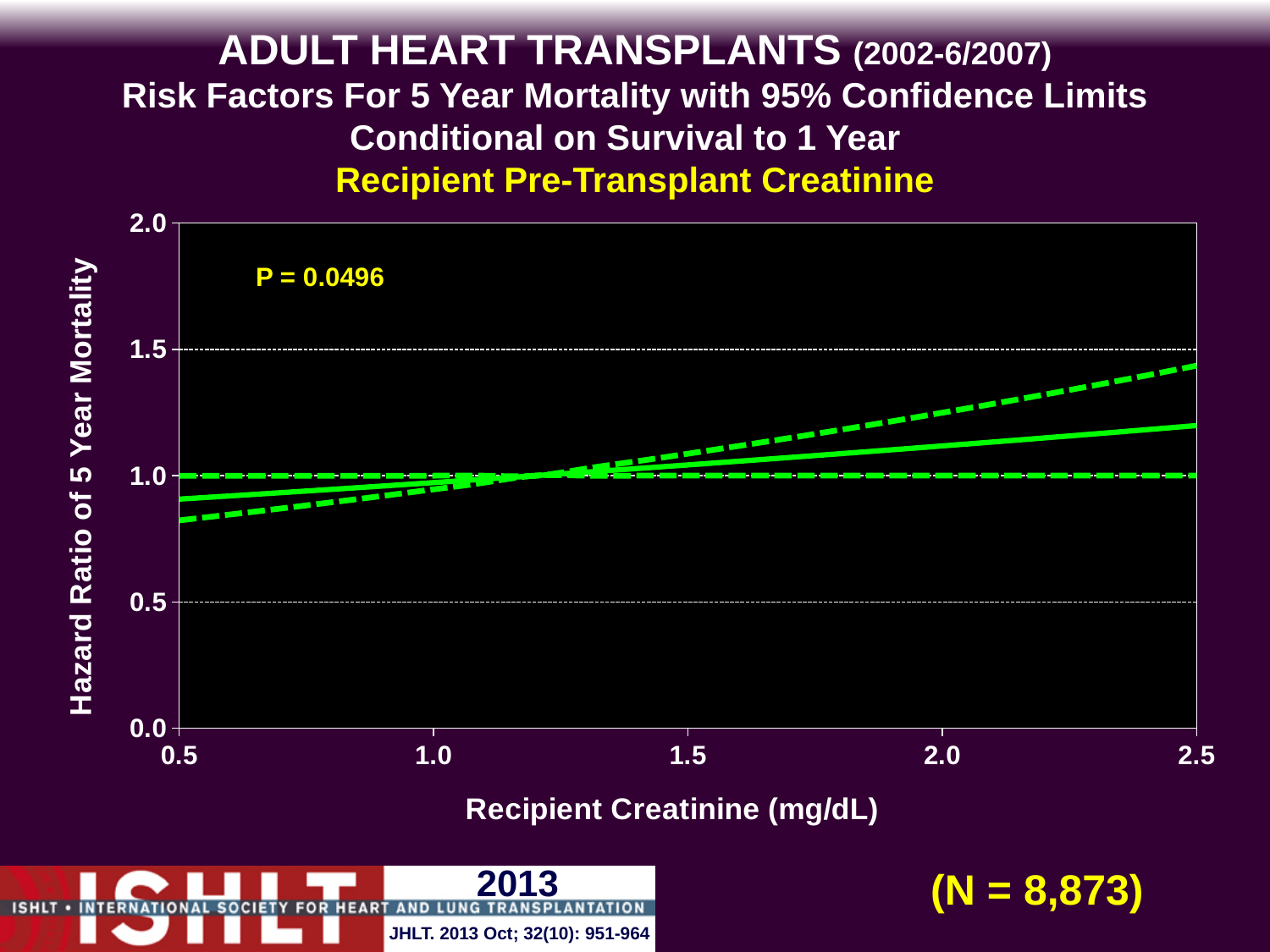
Is the solid hazard ratio line at a recipient creatinine of 2.5 mg/dL greater or less than 1.0? greater Does the solid hazard ratio line rise or fall as recipient creatinine increases from 0.5 to 2.5 mg/dL? rise Is the solid hazard ratio line at a recipient creatinine of 0.5 mg/dL greater or less than 1.0? less How many tick marks are labelled on the x axis of the chart? 5 Is the lower dashed confidence limit at a recipient creatinine of 0.5 mg/dL greater or less than 1.0? less What kind of chart is shown on the slide? line chart What sample size (N) is printed on the slide? (N = 8,873) What P value is printed on the chart? P = 0.0496